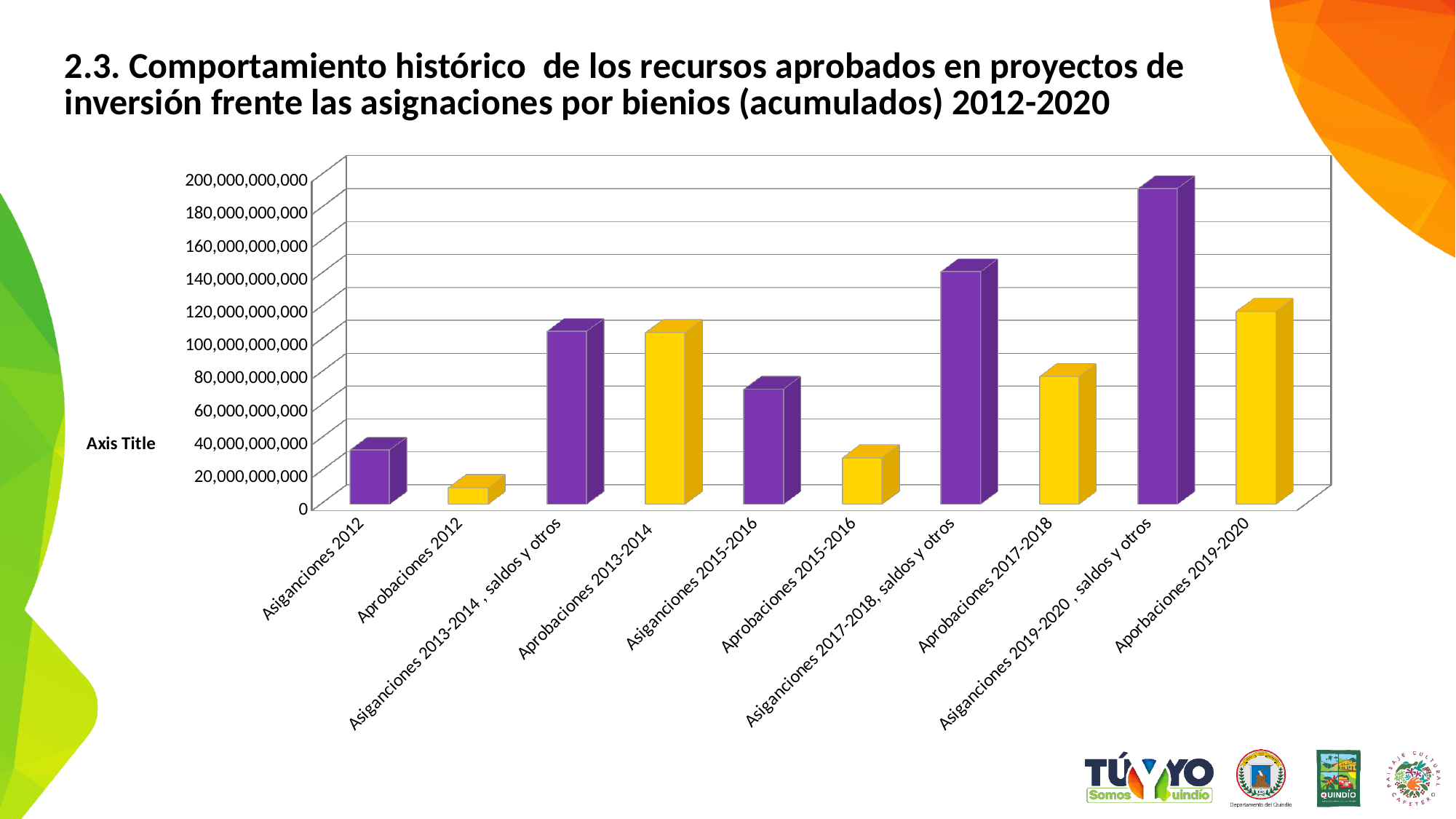
Which is larger, the value for Asiganciones 2015-2016 or the value for Aprobaciones 2015-2016? Asiganciones 2015-2016 Is the value for Aprobaciones 2017-2018 greater or less than 100,000,000,000? less What kind of chart is shown on the slide? Bar chart How many categories are plotted on the x axis of the chart? 10 Is the value for Asiganciones 2012 greater or less than 20,000,000,000? greater Which category has the lowest value in the chart? Aprobaciones 2012 Is the value for Aporbaciones 2019-2020 greater or less than 100,000,000,000? greater Which category has the highest value in the chart? Asiganciones 2019-2020 , saldos y otros Which is larger, the value for Asiganciones 2019-2020 , saldos y otros or the value for Aporbaciones 2019-2020? Asiganciones 2019-2020 , saldos y otros What is the label shown on the vertical axis of the chart? Axis Title